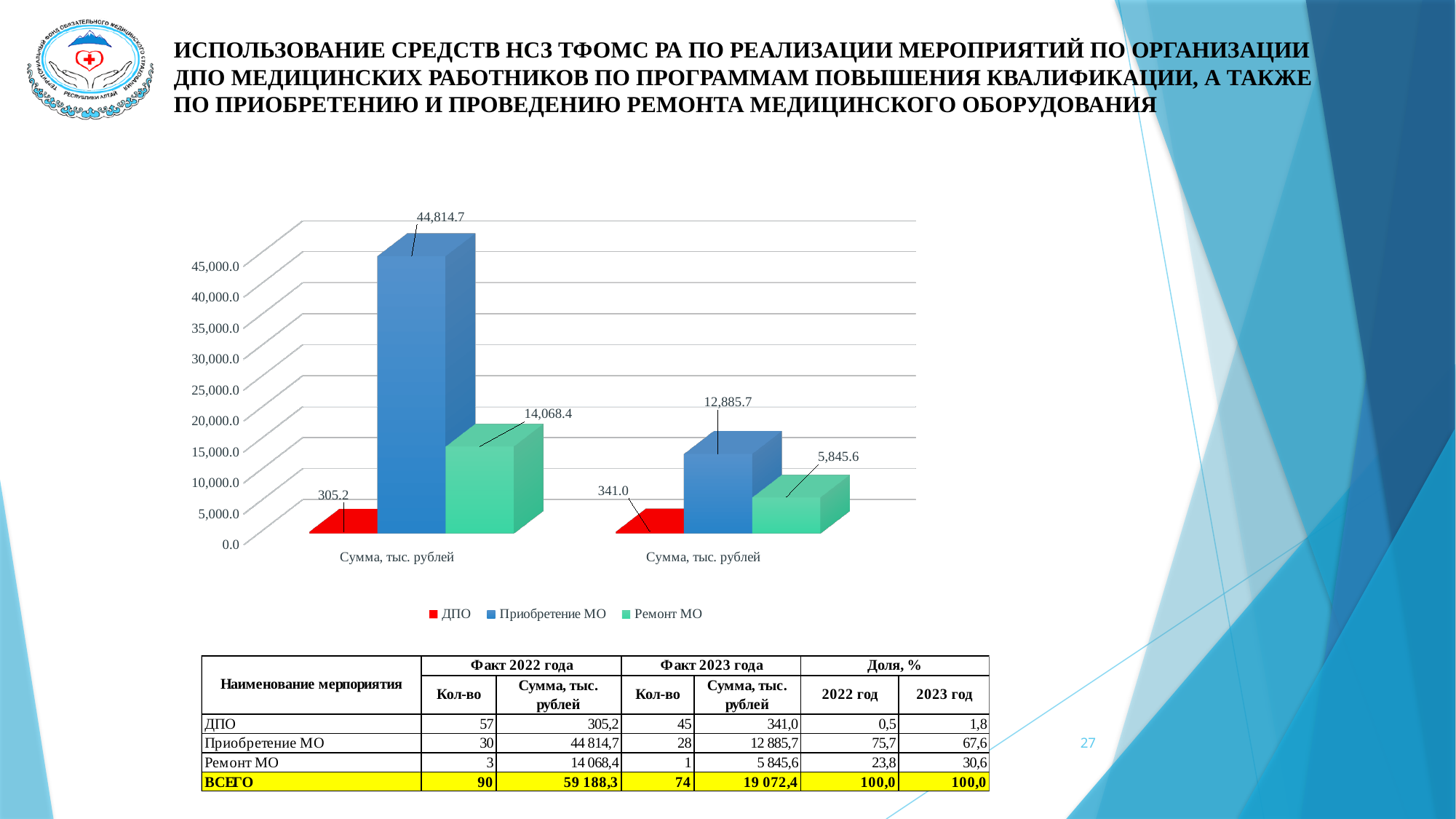
What kind of chart is shown on the slide? bar chart Which is larger: the Приобретение МО value in the left group or in the right group? left group How many series does the chart legend list? 3 In the right group of bars, what is the value for Ремонт МО? 5,845.6 Which series has the highest value in the left group of bars? Приобретение МО In the right group of bars, what is the value for Приобретение МО? 12,885.7 In the right group of bars, what is the value for ДПО? 341.0 Which series has the lowest value in the right group of bars? ДПО Which series is shown in red in the chart legend? ДПО In the left group of bars, what is the value for Приобретение МО? 44,814.7 In the left group of bars, what is the value for ДПО? 305.2 In the left group of bars, what is the value for Ремонт МО? 14,068.4